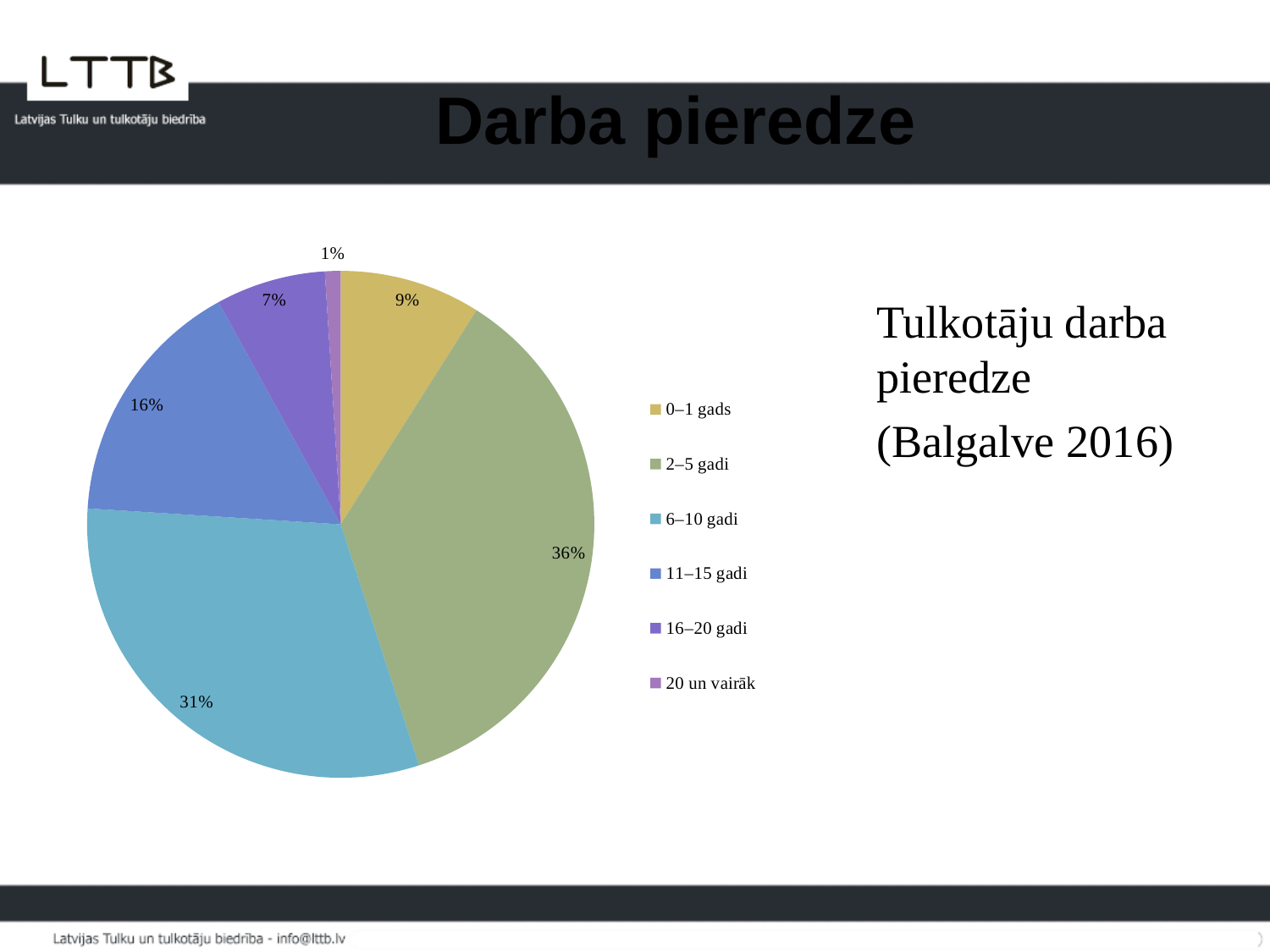
Which category has the largest slice of the pie? 2–5 gadi What is the title of the slide containing the pie chart? Darba pieredze What is the difference between the 11–15 gadi and 16–20 gadi shares? 9% What kind of chart is shown on the slide? pie chart What is the difference between the 2–5 gadi and 6–10 gadi shares? 5% Which is larger, the share for 11–15 gadi or the share for 0–1 gads? 11–15 gadi Which category has the smallest slice of the pie? 20 un vairāk How many categories does the pie chart have? 6 What share of the pie does the 2–5 gadi slice represent? 36% What is the value shown for 0–1 gads? 9% What is the value shown for 16–20 gadi? 7% What is the value shown for 6–10 gadi? 31%